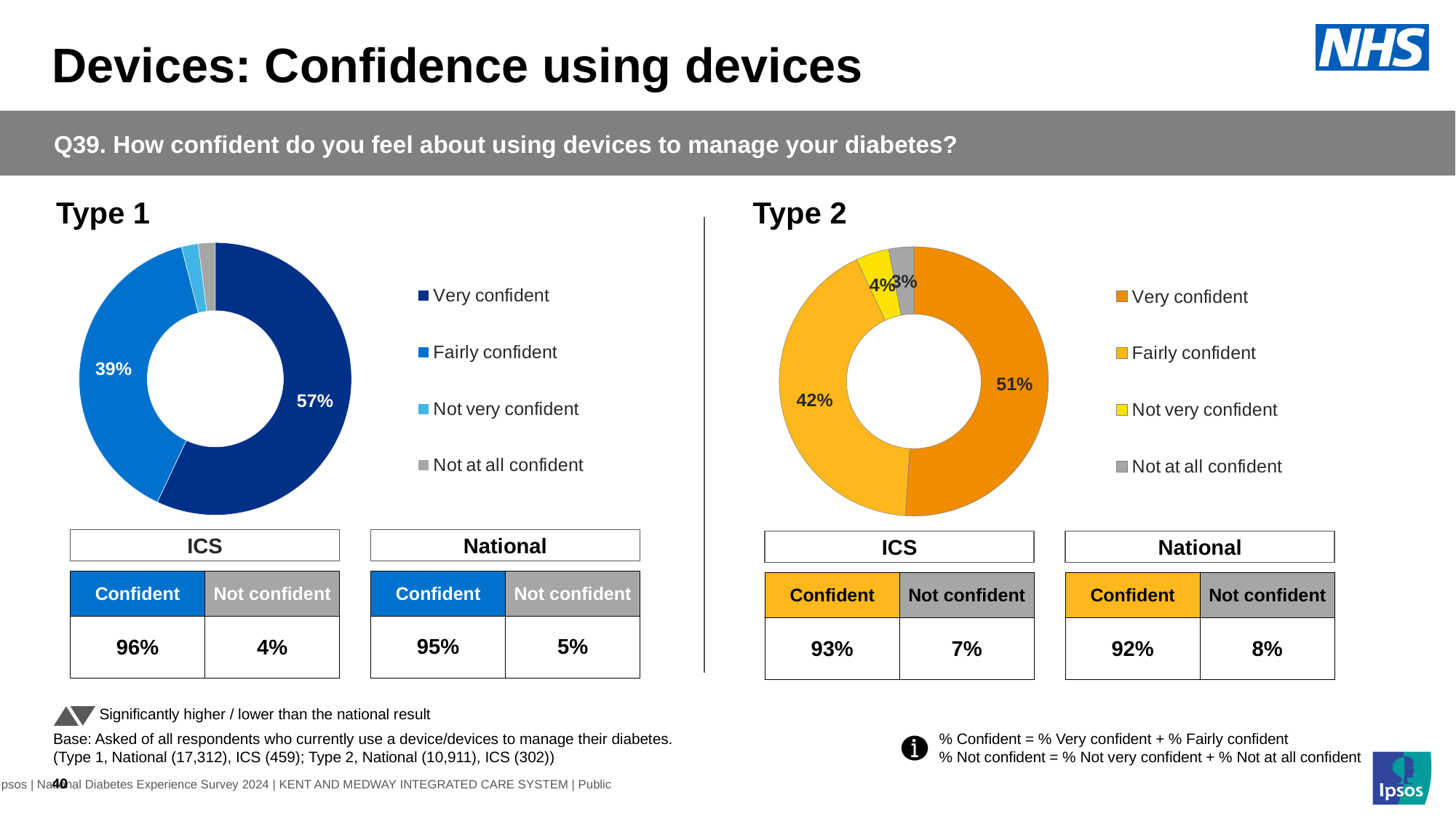
What kind of chart is used for Type 1? Donut (pie) chart In the Type 1 chart, what percentage of respondents are very confident? 57% In the Type 2 chart, what percentage of respondents are not at all confident? 3% In the Type 1 chart, which category has the largest share? Very confident In the Type 2 chart, what percentage of respondents are fairly confident? 42% In the Type 2 chart, which category has the smallest share? Not at all confident In the Type 1 chart, what percentage of respondents are fairly confident? 39% In the Type 2 chart, what percentage of respondents are not very confident? 4% Which is larger in the Type 2 chart: the very confident share or the fairly confident share? Very confident How many categories does the legend of the Type 2 chart list? 4 In the Type 1 chart, what is the difference between the very confident and fairly confident shares? 18% In the Type 2 chart, what percentage of respondents are very confident? 51%